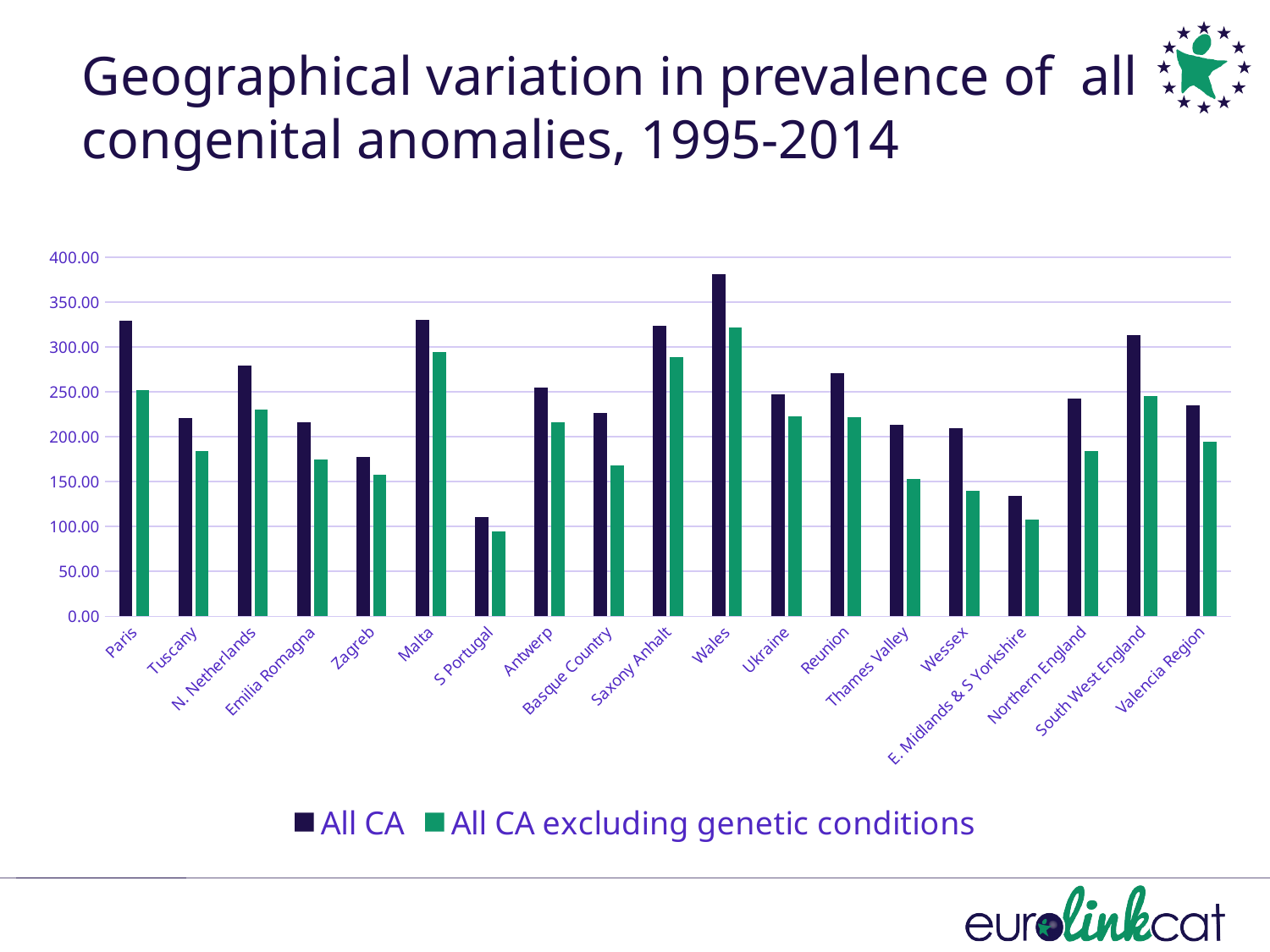
Which region has the lowest value for All CA? S Portugal What type of chart is shown on the slide? bar chart Which has the larger All CA value, Paris or Tuscany? Paris Is the All CA value for South West England greater or less than 300? greater Which has the larger All CA excluding genetic conditions value, Antwerp or Basque Country? Antwerp How many regions are shown on the x axis? 19 How many series does the legend list? 2 Which region has the highest value for All CA? Wales Is the All CA excluding genetic conditions value for Wessex greater or less than 150? less Is the All CA value for Zagreb greater or less than 200? less Which region has the lowest value for All CA excluding genetic conditions? S Portugal